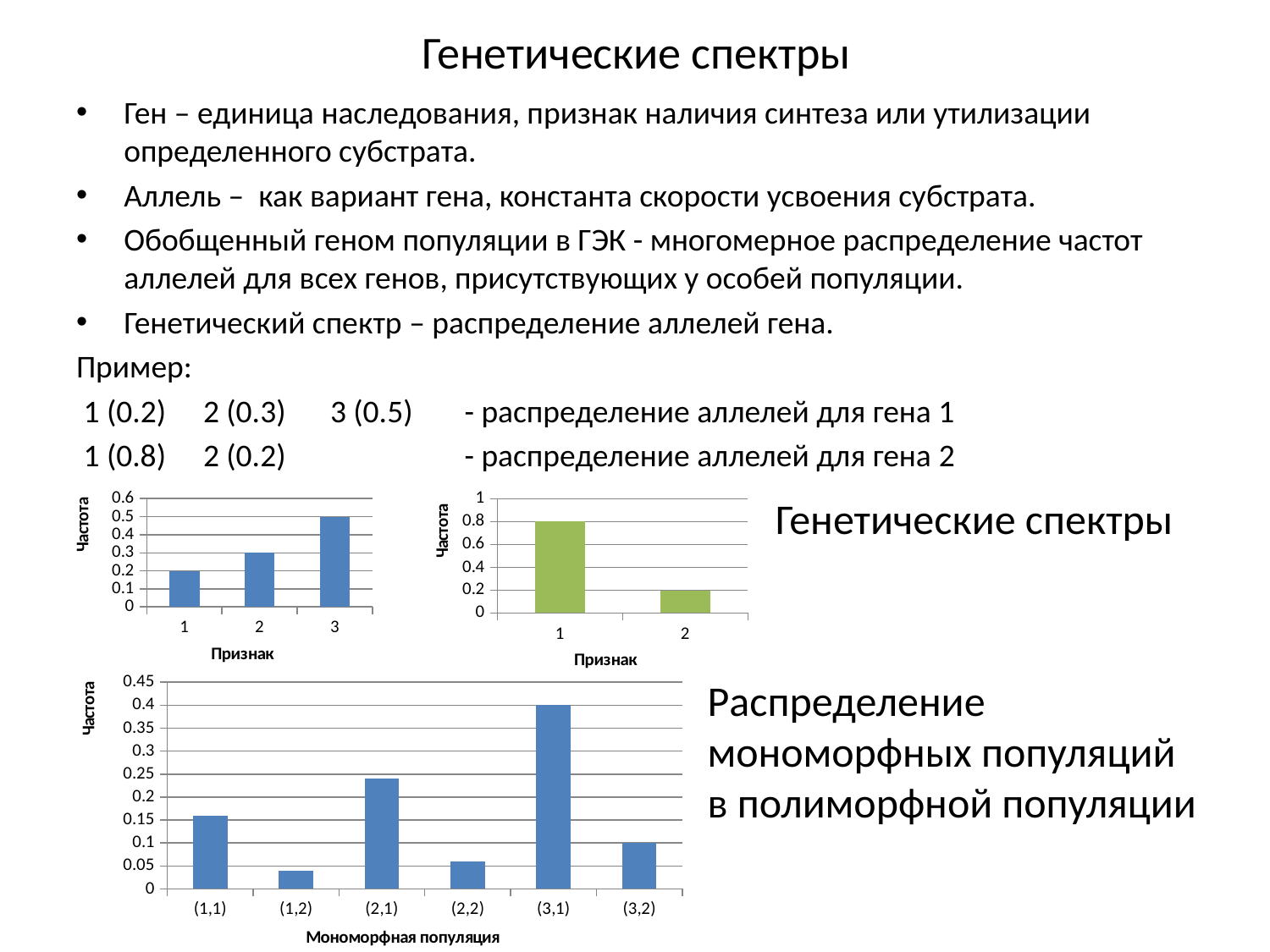
In the top-right chart, what is the difference between the values for category 1 and category 2? 0.6 In the top-left chart, what is the value for category 1? 0.2 In the top-right chart, what is the value for category 1? 0.8 In the top-left chart, which category has the highest value? 3 In the bottom chart, how many categories are shown on the x axis? 6 In the bottom chart, what is the value for (3,1)? 0.4 In the bottom chart, which category has the lowest value? (1,2) What kind of chart is the bottom chart? bar chart In the top-left chart, what is the difference between the values for category 3 and category 2? 0.2 In the top-right chart, how many categories are shown on the x axis? 2 In the top-left chart, what is the value for category 3? 0.5 In the bottom chart, is the value for (2,1) greater or less than 0.2? greater